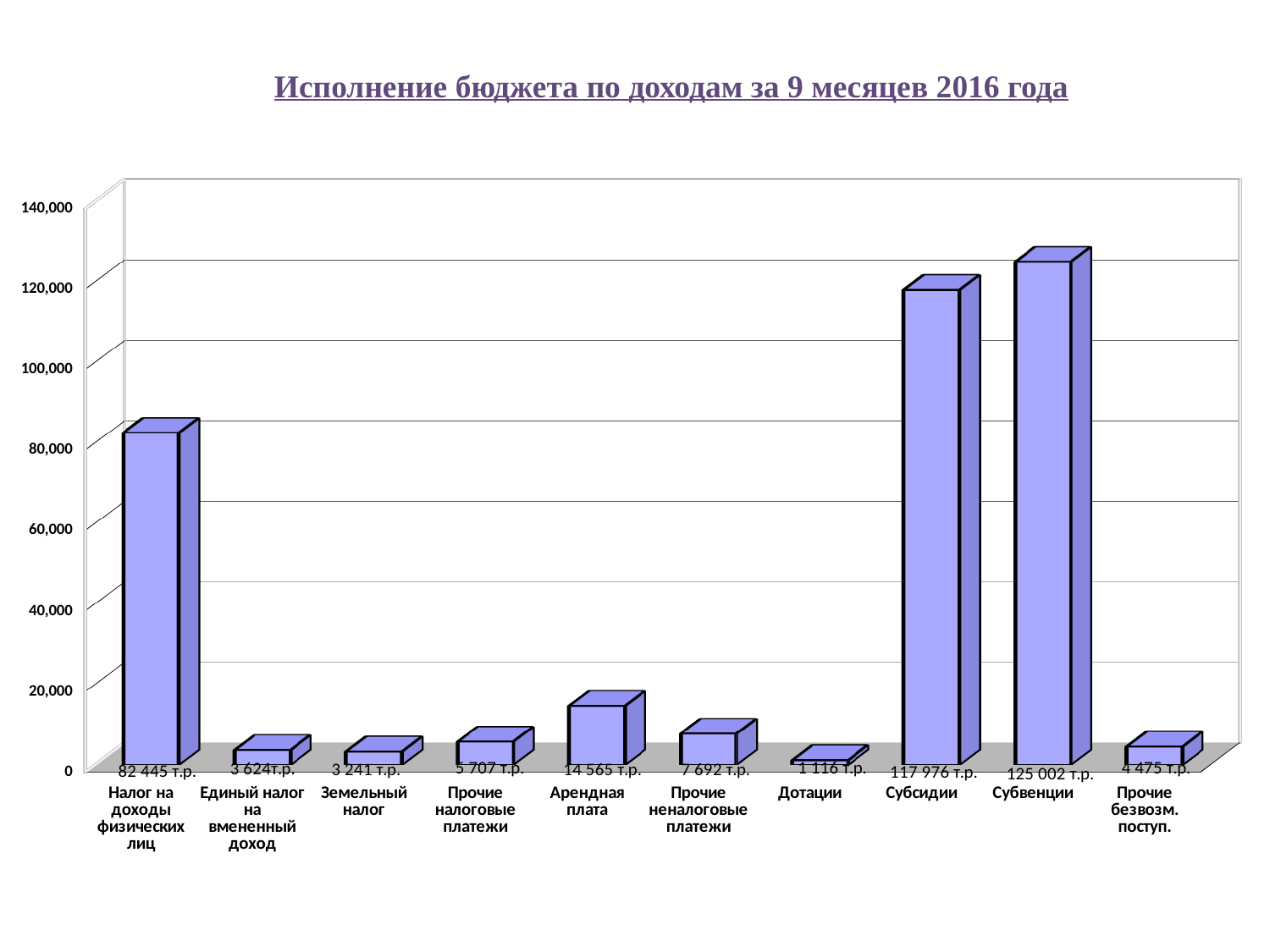
Which is larger, the value for Единый налог на вмененный доход or the value for Земельный налог? Единый налог на вмененный доход Which category has the lowest value? Дотации What is the value for Субсидии? 117 976 т.р. What is the value for Дотации? 1 116 т.р. What is the difference between the values for Арендная плата and Прочие неналоговые платежи? 6 873 т.р. What kind of chart is shown on the slide? Bar chart What is the value for Арендная плата? 14 565 т.р. How many categories are shown on the chart? 10 Which category has the highest value? Субвенции What is the value for Налог на доходы физических лиц? 82 445 т.р. What is the title of the chart? Исполнение бюджета по доходам за 9 месяцев 2016 года What is the difference between the values for Субвенции and Субсидии? 7 026 т.р.